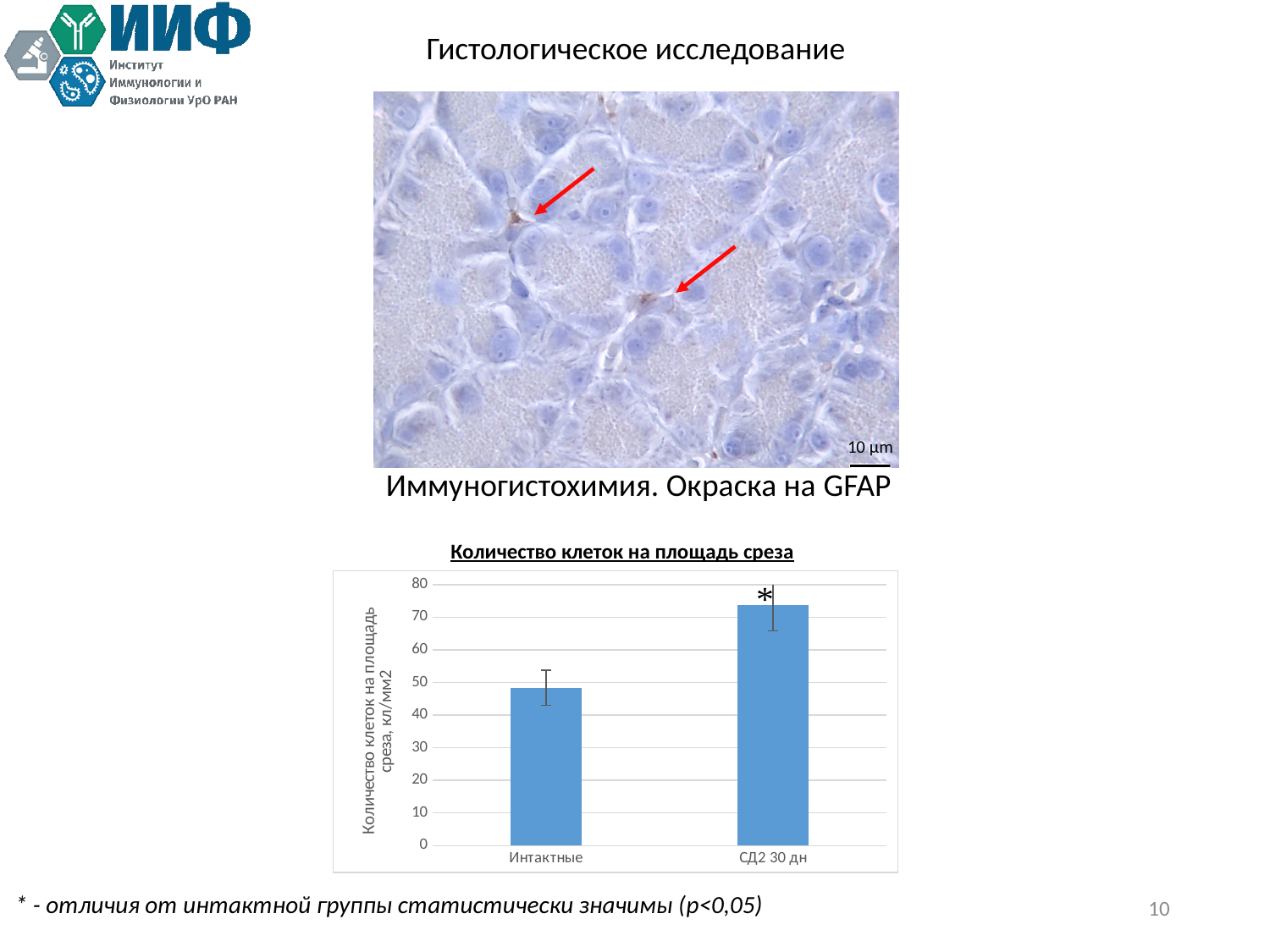
Is the value for СД2 30 дн greater or less than 60? greater Is the value for Интактные greater or less than 60? less Which category has the highest value in the chart? СД2 30 дн How many categories are shown on the x axis of the chart? 2 Is the value for СД2 30 дн greater or less than 80? less Which is larger, the value for Интактные or the value for СД2 30 дн? СД2 30 дн What is the title of the chart? Количество клеток на площадь среза Which category has the lowest value in the chart? Интактные What is the label of the vertical axis of the chart? Количество клеток на площадь среза, кл/мм2 What kind of chart is shown on the slide? bar chart